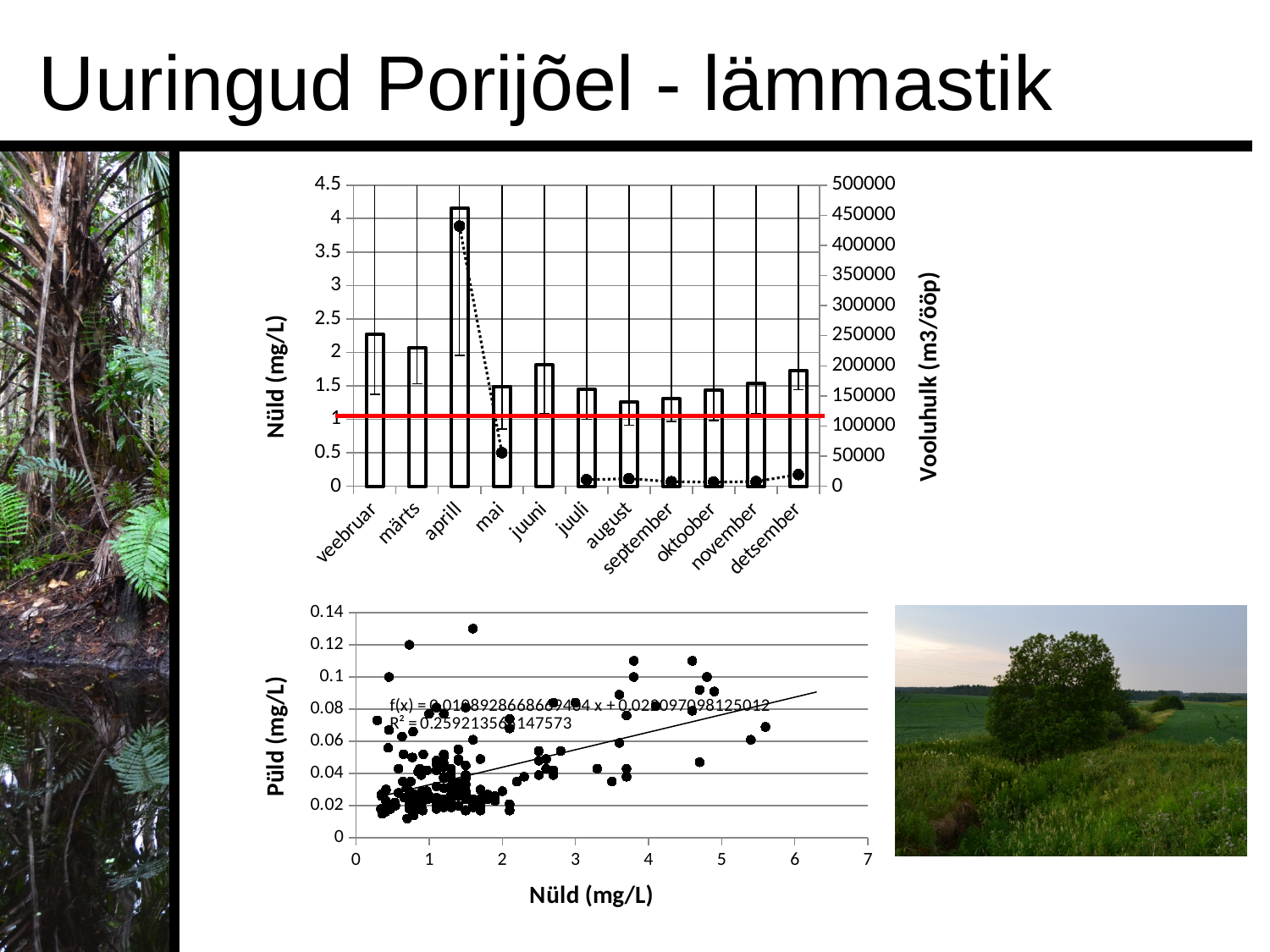
On the bottom chart, what is the label of the x axis? Nüld (mg/L) On the top chart, is the Vooluhulk value for aprill greater or less than 400000? greater On the bottom chart, does the fitted trend line rise or fall as Nüld (mg/L) increases? rises On the top chart, what is the label of the right-hand vertical axis? Vooluhulk (m3/ööp) What kind of chart is the bottom chart? scatter plot On the top chart, which has the higher Nüld bar, veebruar or mai? veebruar On the top chart, is the Nüld value for aprill greater or less than 4? greater On the top chart, is the Nüld value for veebruar greater or less than 2? greater On the top chart, which month has the highest Nüld (mg/L) bar? aprill On the top chart, how many months are shown on the x axis? 11 On the top chart, in which month does the Vooluhulk (m3/ööp) point reach its highest value? aprill